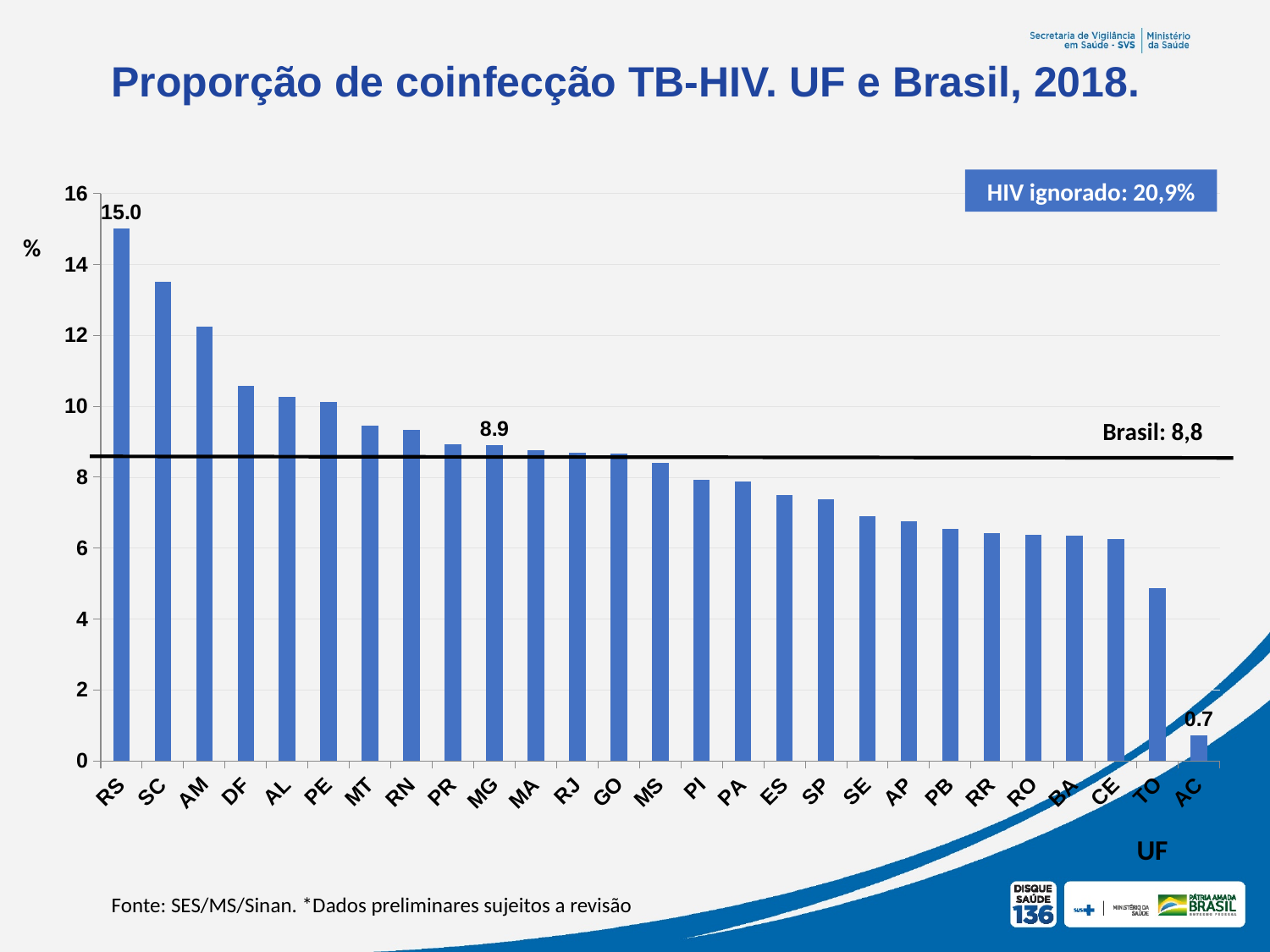
How many UFs are shown on the x axis? 27 What value does the horizontal reference line for Brasil represent? 8,8 Which has a larger value, SC or AM? SC Which UF has the lowest proportion of TB-HIV coinfection? AC Is the value for DF greater or less than 10? greater What is the value for AC? 0.7 What kind of chart is shown on the slide? bar chart Which UF has the highest proportion of TB-HIV coinfection? RS What is the value for RS? 15.0 What is the difference between the values for RS and AC? 14.3 Is the value for TO greater or less than 6? less What is the value for MG? 8.9